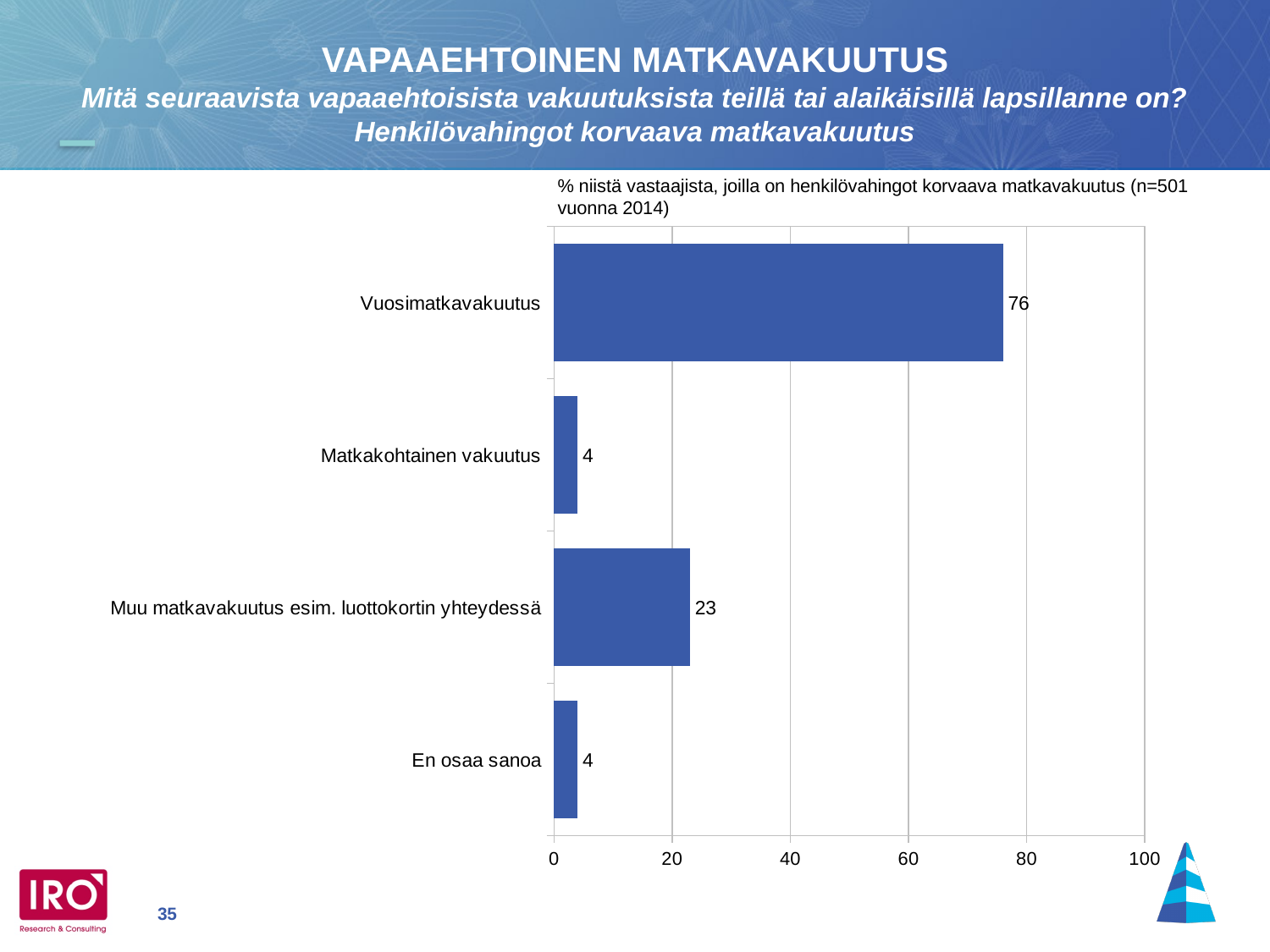
Which category has the highest value? Vuosimatkavakuutus Which is larger, the value for Muu matkavakuutus esim. luottokortin yhteydessä or the value for Matkakohtainen vakuutus? Muu matkavakuutus esim. luottokortin yhteydessä How many categories are shown in the chart? 4 What kind of chart is shown on the slide? bar chart What is the value for Muu matkavakuutus esim. luottokortin yhteydessä? 23 What is the value for En osaa sanoa? 4 What is the value for Matkakohtainen vakuutus? 4 What is the value for Vuosimatkavakuutus? 76 What is the difference between the values for Vuosimatkavakuutus and Muu matkavakuutus esim. luottokortin yhteydessä? 53 Is the value for Vuosimatkavakuutus greater or less than 60? greater What is the difference between the values for Muu matkavakuutus esim. luottokortin yhteydessä and Matkakohtainen vakuutus? 19 What is the highest value shown on the x axis? 100